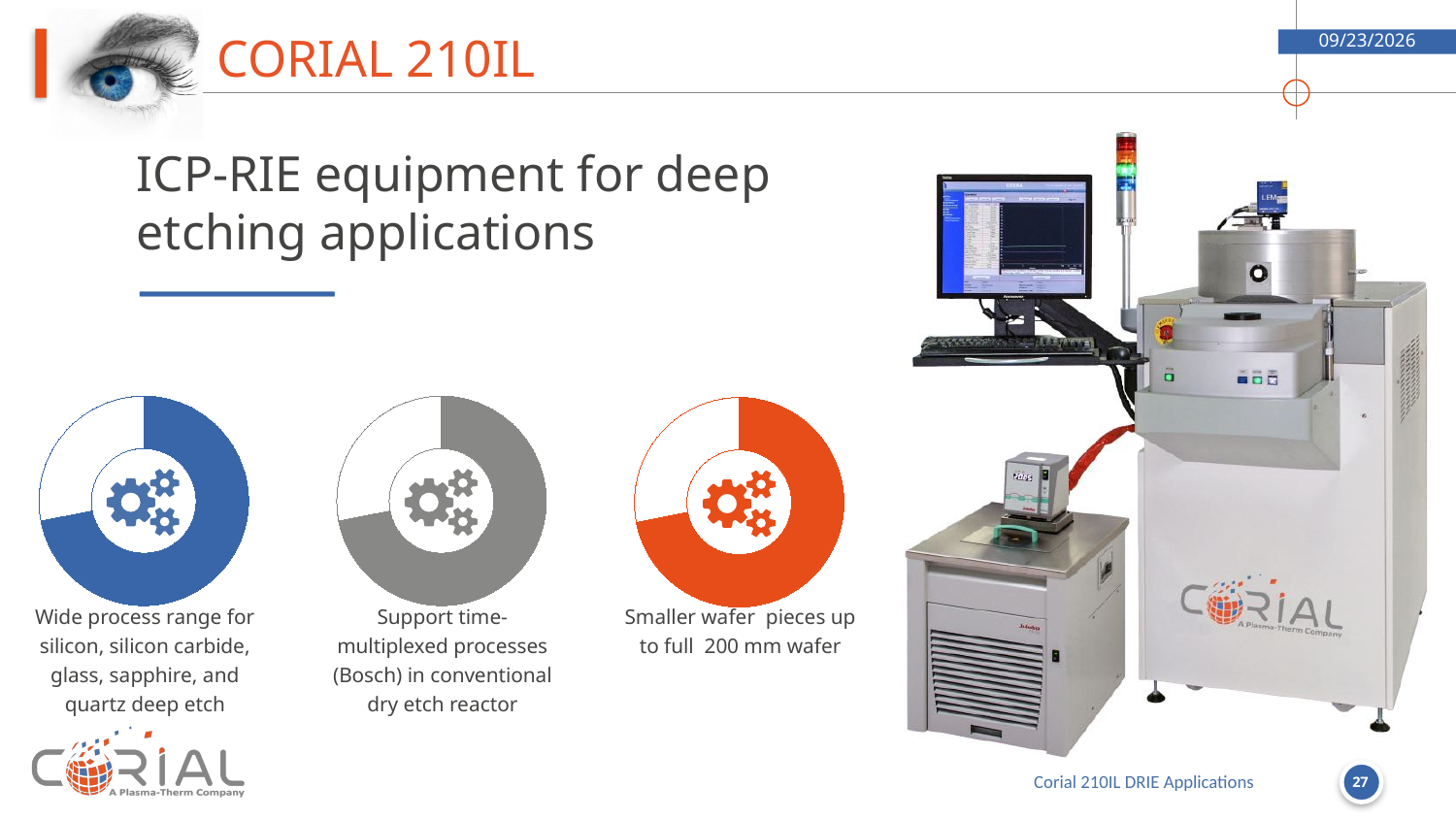
What kind of chart are the three circular graphics in the lower left of the slide? doughnut chart In the middle doughnut chart, is the dark grey segment larger or smaller than the light grey segment? larger What colour is the leftmost doughnut chart, above the text 'Wide process range for silicon, silicon carbide, glass, sapphire, and quartz deep etch'? blue What colour is the rightmost doughnut chart, above the text 'Smaller wafer pieces up to full 200 mm wafer'? orange How many doughnut charts are shown on the slide? 3 In the leftmost doughnut chart, is the dark blue segment larger or smaller than the light blue segment? larger